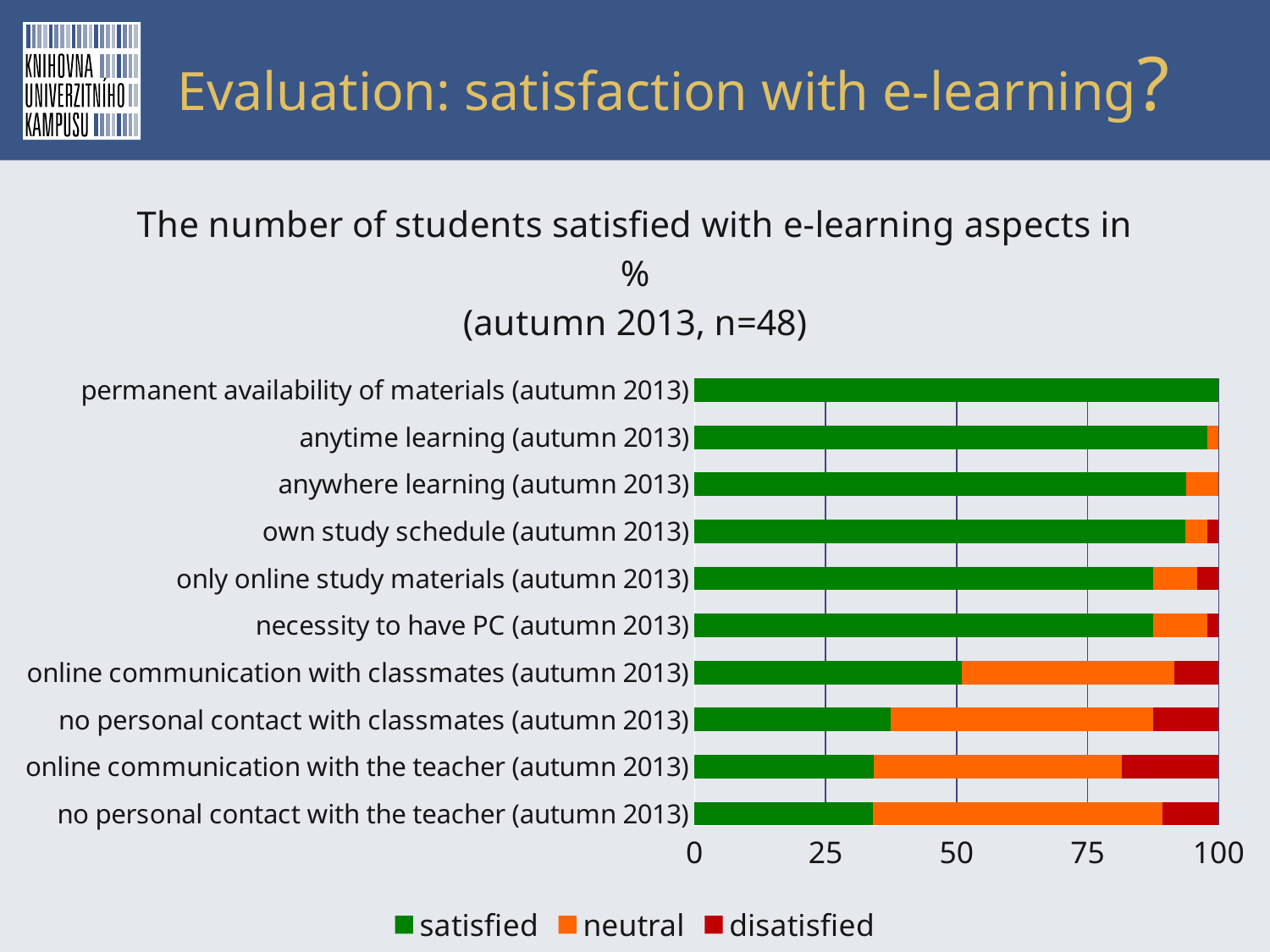
What kind of chart is shown on the slide? stacked bar chart Is the 'satisfied' value for 'online communication with the teacher (autumn 2013)' greater or less than 50? less Is the 'satisfied' value for 'only online study materials (autumn 2013)' greater or less than 75? greater How many series does the legend list? 3 What are the three series named in the legend? satisfied, neutral, disatisfied Is the 'satisfied' value for 'no personal contact with classmates (autumn 2013)' greater or less than 50? less How many categories (bars) does the chart show? 10 What is the sample size stated in the chart title? n=48 Which has a larger 'neutral' segment: 'online communication with classmates (autumn 2013)' or 'necessity to have PC (autumn 2013)'? online communication with classmates (autumn 2013) Which has a larger 'satisfied' share: 'anywhere learning (autumn 2013)' or 'no personal contact with classmates (autumn 2013)'? anywhere learning (autumn 2013) Which category has the largest 'disatisfied' segment? online communication with the teacher (autumn 2013)